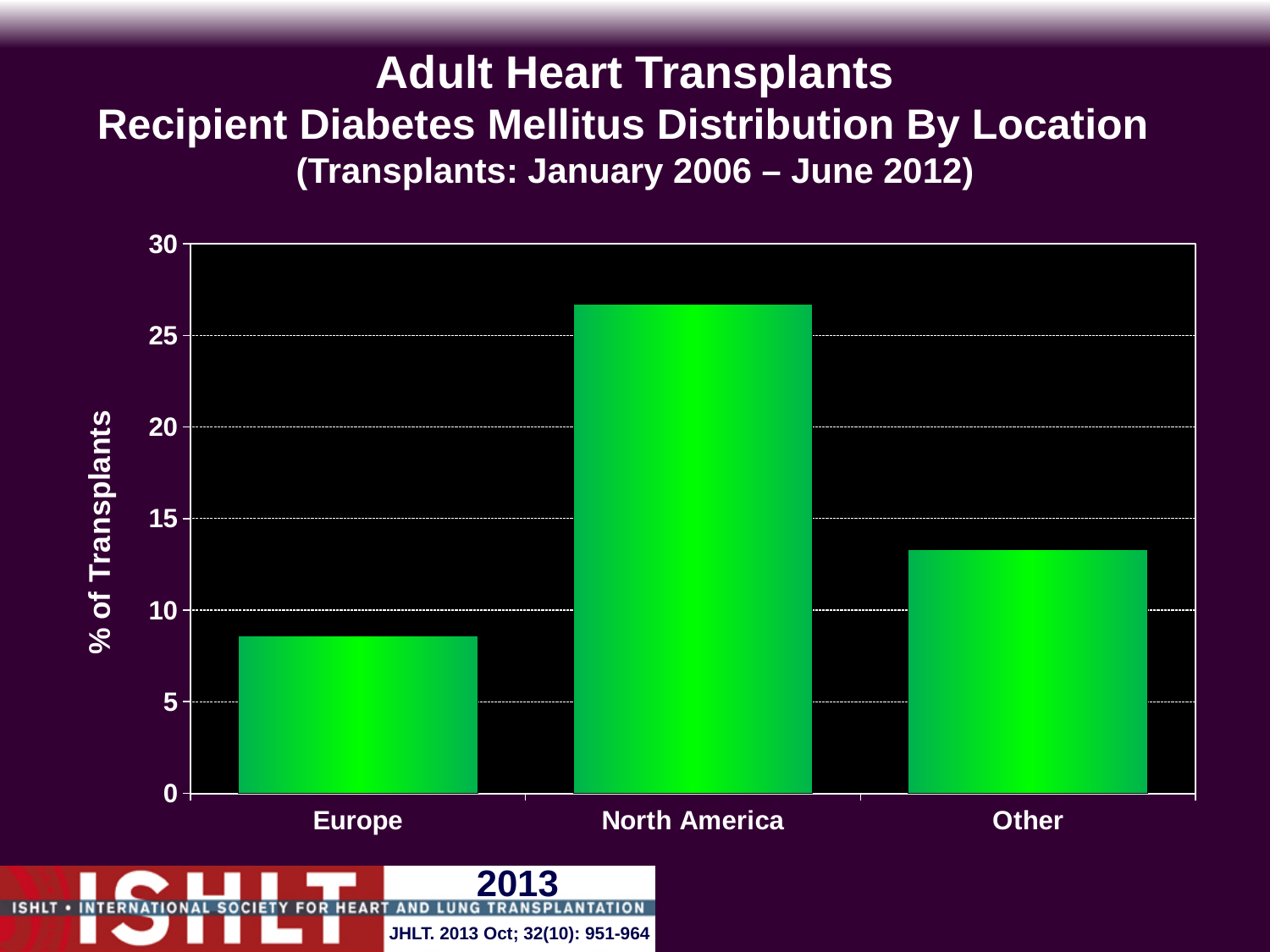
Is the value for North America greater or less than 25? greater Which location has the highest percentage of transplants? North America Which location has the lowest percentage of transplants? Europe Is the value for Other greater or less than 15? less Is the value for Other greater or less than 10? greater How many location categories are plotted on the chart? 3 What kind of chart is shown on the slide? bar chart What is the label of the y axis? % of Transplants What transplant date range is given in the chart title? January 2006 – June 2012 Which is larger, the value for Europe or the value for Other? Other Which is larger, the value for North America or the value for Other? North America